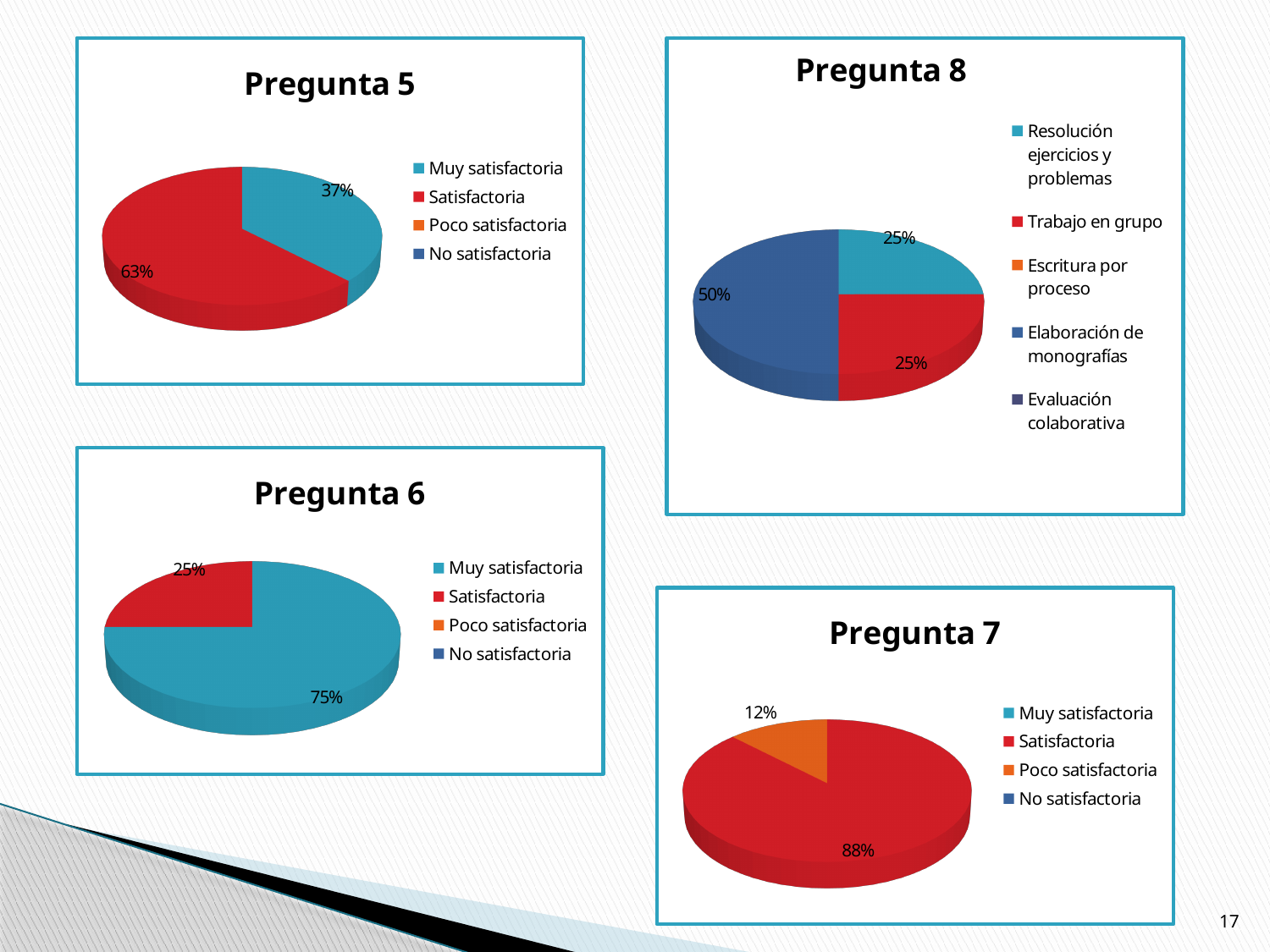
What type of chart is the Pregunta 6 chart? Pie chart In the Pregunta 7 chart, what percentage is shown for Poco satisfactoria? 12% In the Pregunta 6 chart, what percentage is shown for Muy satisfactoria? 75% In the Pregunta 7 chart, which category has the largest slice? Satisfactoria How many entries does the legend of the Pregunta 8 chart list? 5 In the Pregunta 8 chart, what is the percentage of the largest slice? 50% In the Pregunta 5 chart, what percentage is shown for Satisfactoria? 63% In the Pregunta 5 chart, which category has the largest slice? Satisfactoria In the Pregunta 5 chart, what percentage is shown for Muy satisfactoria? 37% In the Pregunta 8 chart, what percentage is shown for Trabajo en grupo? 25% In the Pregunta 7 chart, which is larger, Satisfactoria or Poco satisfactoria? Satisfactoria In the Pregunta 6 chart, what is the difference between the Muy satisfactoria and Satisfactoria shares? 50%